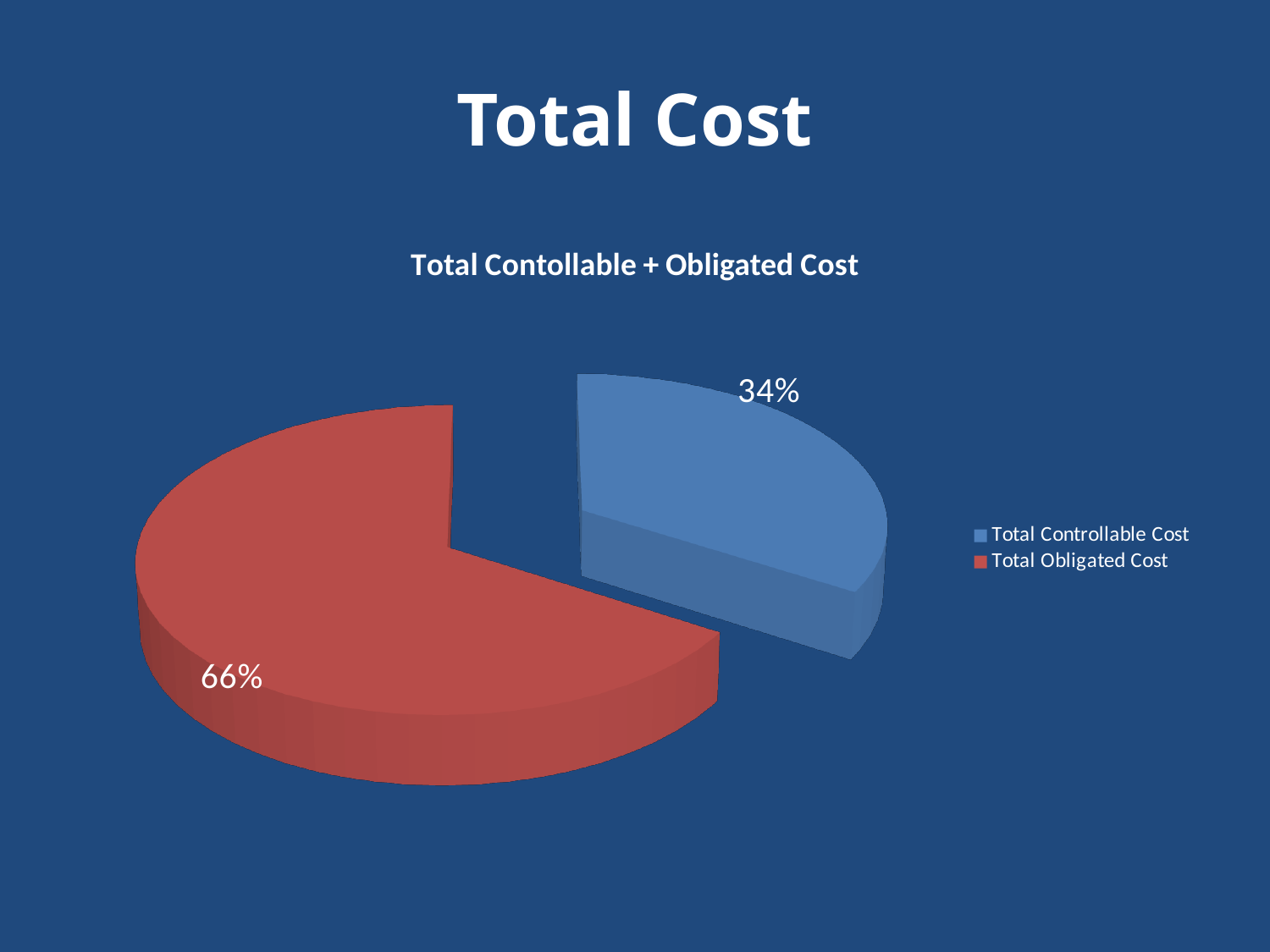
Is the share for Total Controllable Cost greater or less than 50%? less How many slices does the pie chart have? 2 What colour is the Total Obligated Cost slice? Red Which is larger, Total Controllable Cost or Total Obligated Cost? Total Obligated Cost What share of the pie does Total Controllable Cost represent? 34% What kind of chart is shown on the slide? Pie chart What is the title of the chart? Total Contollable + Obligated Cost Which slice is the largest? Total Obligated Cost What is the difference in percentage points between Total Obligated Cost and Total Controllable Cost? 32 How many entries does the legend list? 2 Which slice is the smallest? Total Controllable Cost What share of the pie does Total Obligated Cost represent? 66%